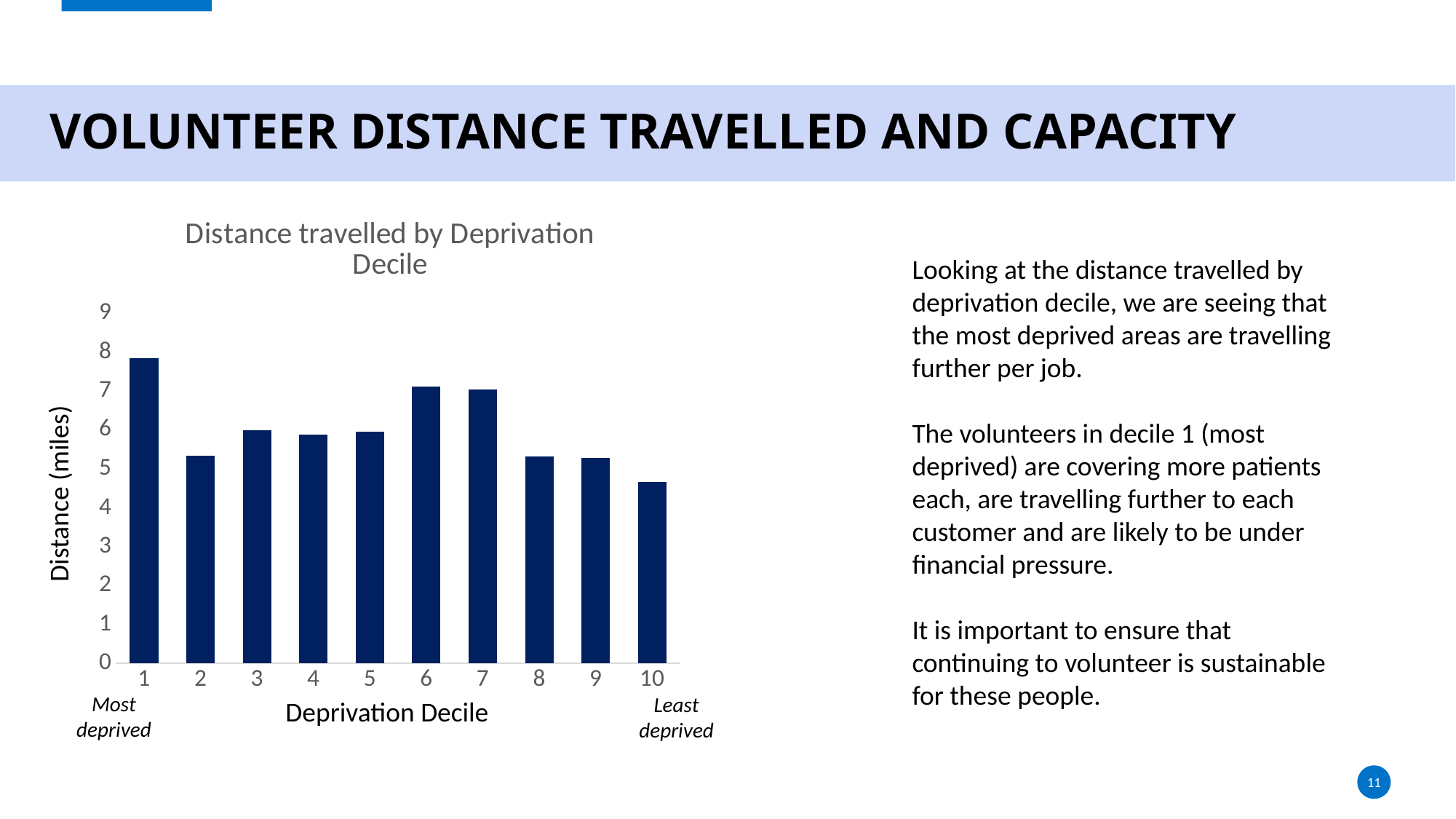
Which has a larger distance travelled, decile 6 or decile 9? Decile 6 What is the title of the chart? Distance travelled by Deprivation Decile What is the label of the vertical axis of the chart? Distance (miles) How many deprivation deciles are plotted on the chart? 10 Is the distance travelled for decile 2 greater or less than 6 miles? less What kind of chart is shown on the slide? Bar chart Which deprivation decile has the highest distance travelled? 1 Is the distance travelled for decile 6 greater or less than 6 miles? greater Which has a larger distance travelled, decile 1 or decile 10? Decile 1 Is the distance travelled for decile 1 greater or less than 7 miles? greater Which deprivation decile has the lowest distance travelled? 10